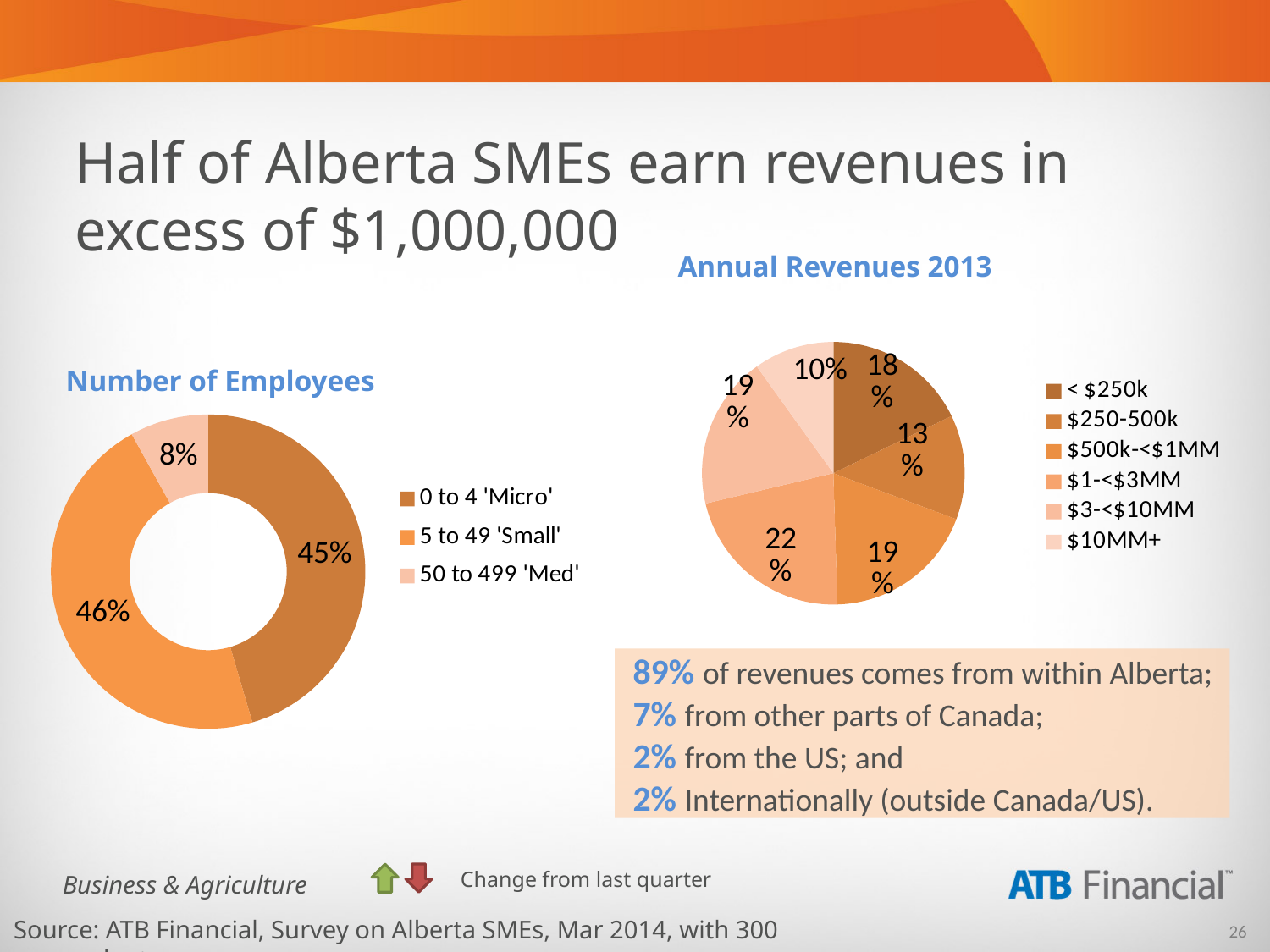
In the Annual Revenues 2013 chart, which revenue category has the smallest share? $10MM+ In the Annual Revenues 2013 chart, what share of SMEs earn $250-500k? 13% In the Number of Employees chart, which category has the smallest share? 50 to 499 'Med' In the Number of Employees chart, what percentage of SMEs have 0 to 4 'Micro' employees? 45% In the Annual Revenues 2013 chart, what share of SMEs earn $1-<$3MM? 22% What kind of chart is the Number of Employees chart? Doughnut chart How many categories does the legend of the Annual Revenues 2013 chart list? 6 In the Annual Revenues 2013 chart, which is larger: the share for < $250k or the share for $250-500k? < $250k In the Number of Employees chart, what percentage of SMEs have 50 to 499 'Med' employees? 8% What kind of chart is the Annual Revenues 2013 chart? Pie chart In the Annual Revenues 2013 chart, which revenue category has the largest share? $1-<$3MM In the Number of Employees chart, what is the difference between the 5 to 49 'Small' share and the 50 to 499 'Med' share? 38%